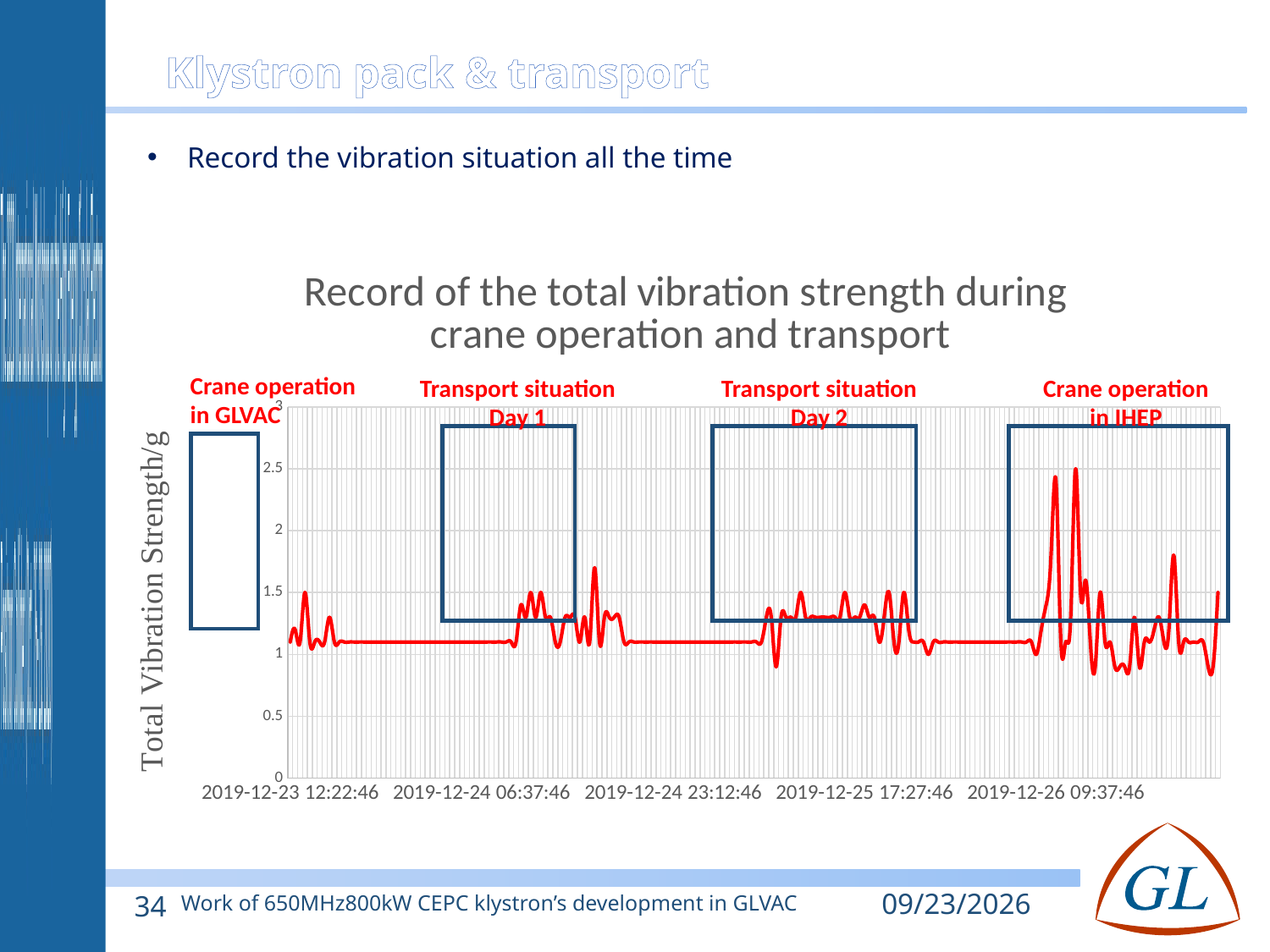
What is the last timestamp label on the x axis? 2019-12-26 09:37:46 Is the highest peak during the Transport situation Day 1 greater or less than 2? less Is the baseline vibration strength between the annotated regions greater or less than 1.5? less In which annotated region does the vibration strength reach its highest peak? Crane operation in IHEP What is the title of the chart? Record of the total vibration strength during crane operation and transport What is the label of the vertical axis of the chart? Total Vibration Strength/g How many annotated regions (boxes) are marked on the chart? 4 What is the first timestamp label on the x axis? 2019-12-23 12:22:46 Is the highest peak during the Crane operation in IHEP greater or less than 2? greater How many timestamp labels are shown along the x axis? 5 What is the highest tick value shown on the vertical axis? 3 What kind of chart is shown on the slide? line chart